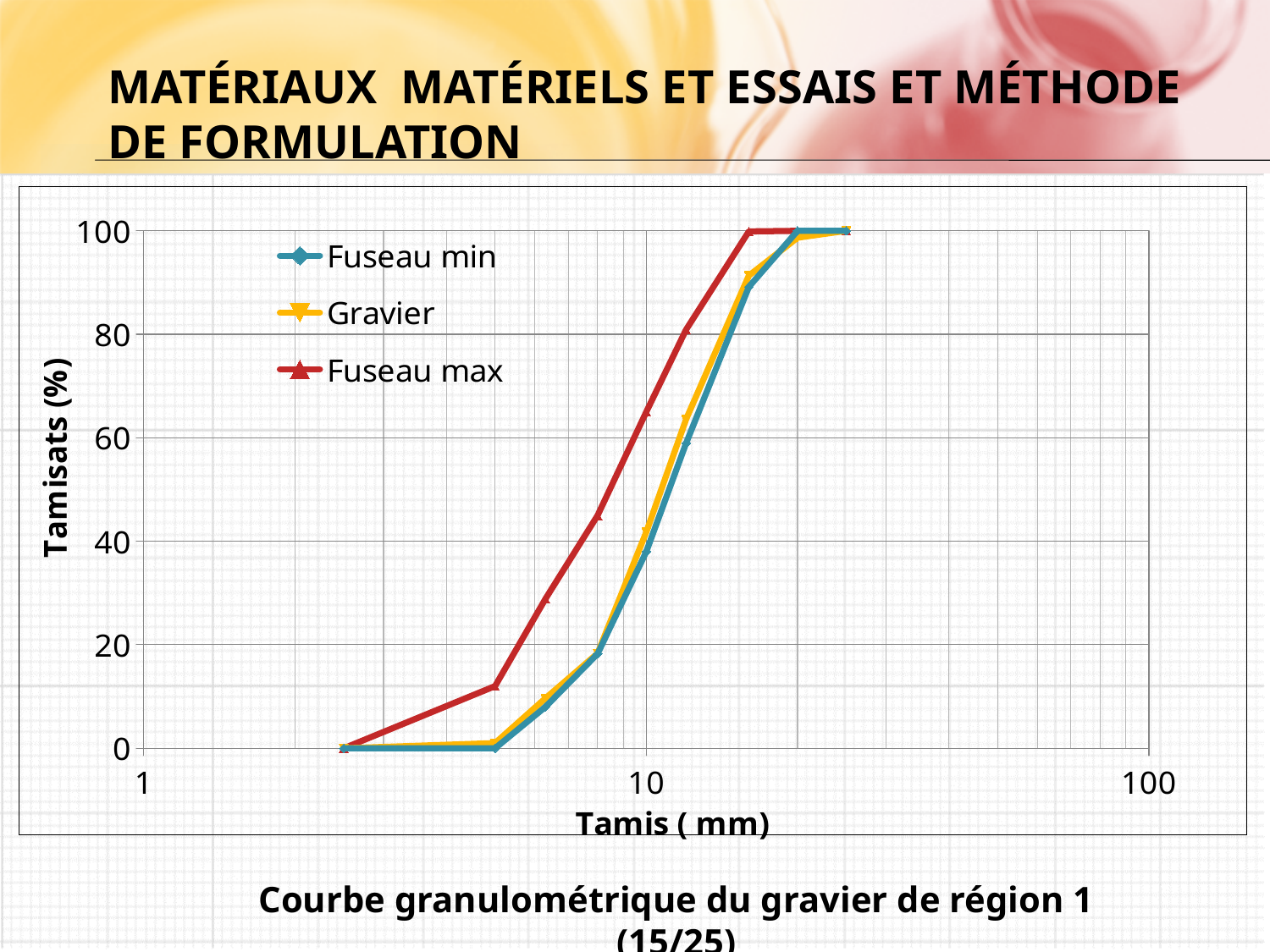
Do the values of the Gravier series rise or fall as the sieve size (Tamis) increases? rise What is the highest value reached by the Fuseau max series? 100 At a sieve size of 10 mm, which series has the larger value, Fuseau max or Fuseau min? Fuseau max Is the value of Fuseau max at 5 mm greater or less than 20? less What is the title of the y axis? Tamisats (%) How many series does the legend list? 3 Is the value of Fuseau max at 10 mm greater or less than 40? greater What are the three series named in the legend? Fuseau min, Gravier, Fuseau max Is the value of Fuseau min at 10 mm greater or less than 60? less Which series lies above the other two across the middle of the sieve-size range? Fuseau max What kind of chart is shown on the slide? line chart